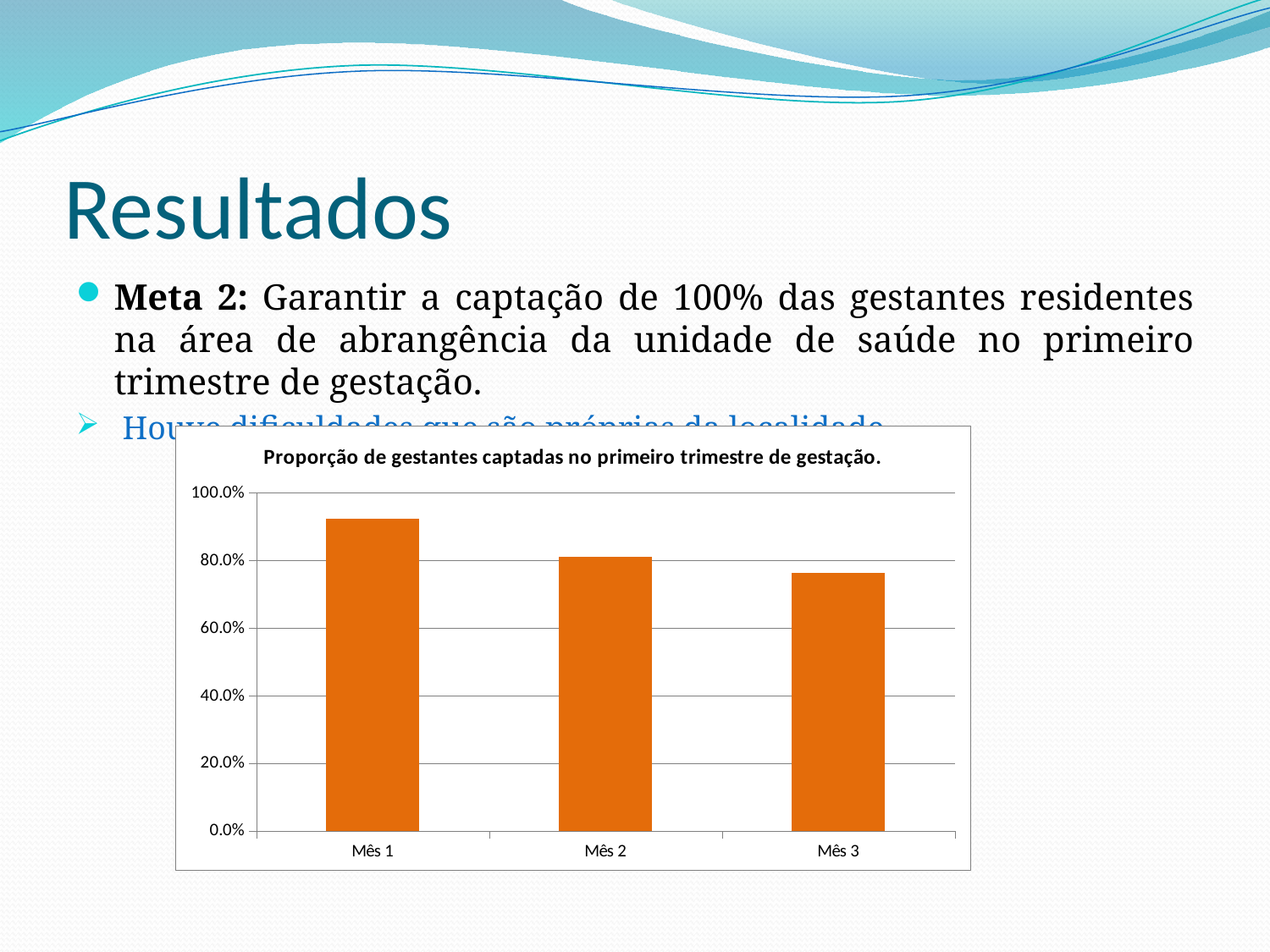
Is the value for Mês 3 greater or less than 80.0%? less Is the value for Mês 1 greater or less than 80.0%? greater Which month has the lowest proportion of pregnant women captured in the first trimester? Mês 3 What is the title of the chart? Proporção de gestantes captadas no primeiro trimestre de gestação. Which is larger, the value for Mês 1 or the value for Mês 3? Mês 1 Which month has the highest proportion of pregnant women captured in the first trimester? Mês 1 Is the value for Mês 1 greater or less than 100.0%? less Do the values rise or fall from Mês 1 to Mês 3? fall Which is larger, the value for Mês 2 or the value for Mês 3? Mês 2 How many categories (months) are plotted on the chart? 3 What kind of chart is shown on the slide? bar chart